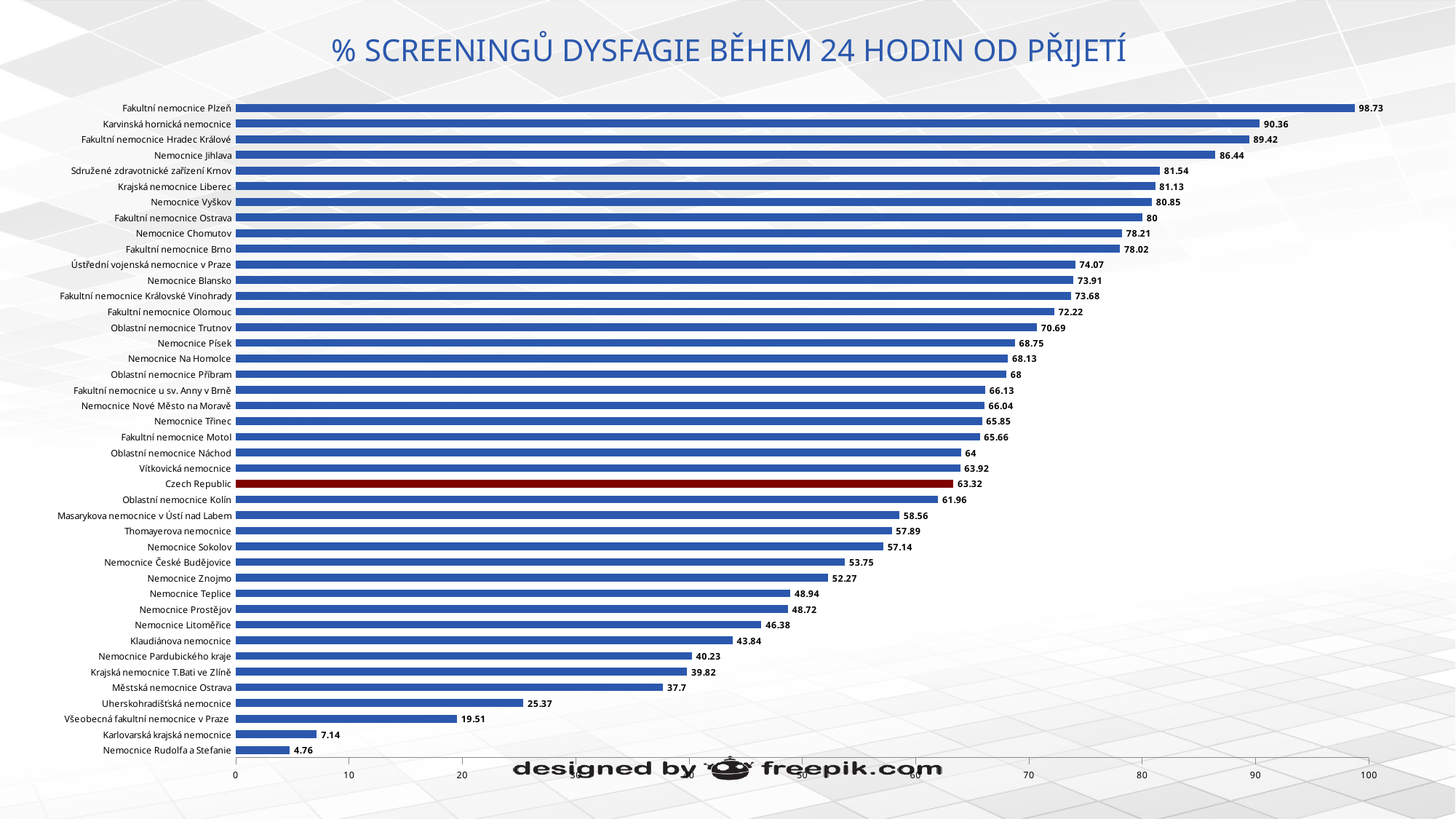
Is the value for Všeobecná fakultní nemocnice v Praze greater or less than 20? less What is the value for Czech Republic? 63.32 What is the value for Fakultní nemocnice Motol? 65.66 What is the value for Fakultní nemocnice Plzeň? 98.73 Which hospital has the lowest value? Nemocnice Rudolfa a Stefanie How many categories are shown on the chart? 42 What kind of chart is shown on the slide? bar chart Which bar is shown in a different colour (dark red) from the others? Czech Republic What is the value for Nemocnice Rudolfa a Stefanie? 4.76 Which has a larger value, Nemocnice Jihlava or Nemocnice Znojmo? Nemocnice Jihlava What is the difference between the values for Fakultní nemocnice Plzeň and Czech Republic? 35.41 Which hospital has the highest value? Fakultní nemocnice Plzeň